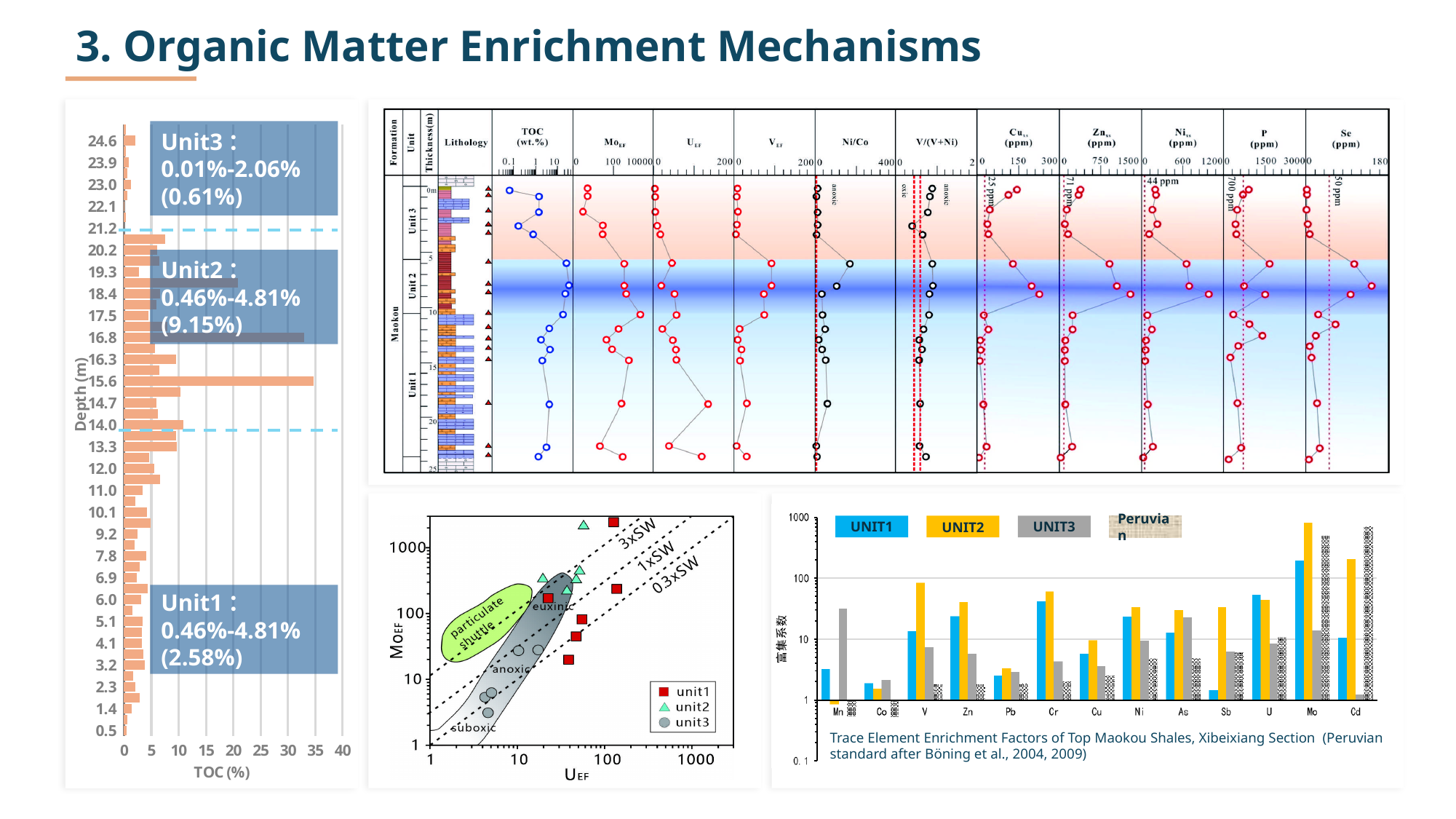
According to the label on the left chart, what is the TOC range given for Unit3? 0.01%-2.06% In the TOC (%) bar chart on the left, is the value at depth 24.6 greater or less than 5? less How many series does the legend of the MoEF versus UEF scatter plot at the bottom middle list? 3 In the TOC (%) bar chart on the left, which depth has the highest TOC value? 15.6 In the trace element enrichment factor bar chart at the bottom right, for which element is the UNIT2 bar highest? Mo In the TOC (%) bar chart on the left, is the value at depth 15.6 greater or less than 30? greater In the trace element enrichment factor bar chart at the bottom right, is the UNIT2 value for Mo greater or less than 100? greater How many elements are shown on the x axis of the trace element enrichment factor bar chart at the bottom right? 13 In the trace element enrichment factor bar chart at the bottom right, which series has the larger value for V, UNIT1 or UNIT2? UNIT2 According to the label on the left chart, what value is given in parentheses for Unit1? 2.58% What type of chart is the TOC (%) versus Depth (m) chart on the left of the slide? bar chart How many series does the legend of the trace element enrichment factor bar chart at the bottom right list? 4